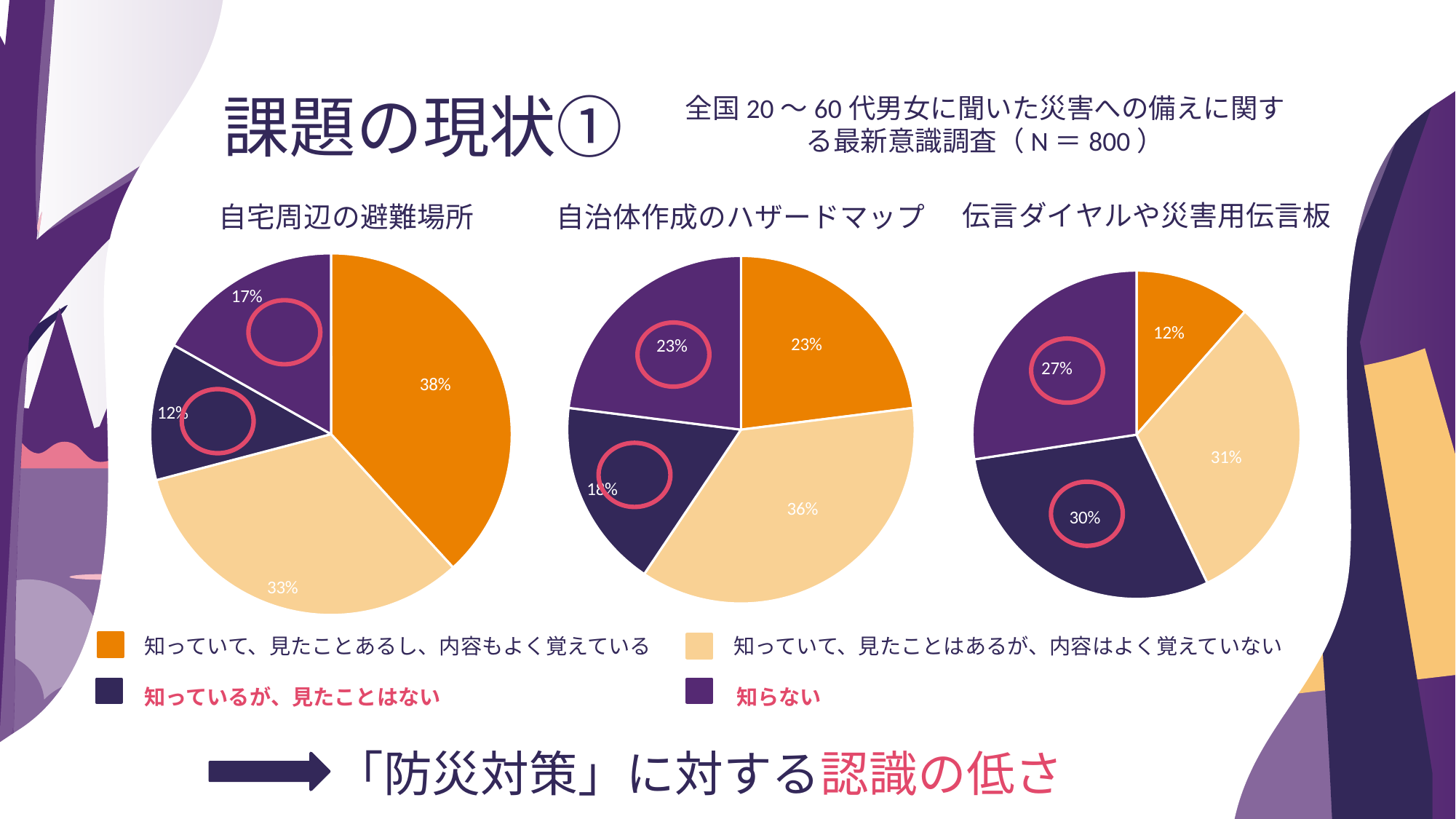
In the 自治体作成のハザードマップ pie chart, what share is labelled for 知っていて、見たことはあるが、内容はよく覚えていない? 36% In the 自宅周辺の避難場所 pie chart, which category has the largest share? 知っていて、見たことあるし、内容もよく覚えている In the 伝言ダイヤルや災害用伝言板 pie chart, what share is labelled for 知らない? 27% In the 自宅周辺の避難場所 pie chart, what is the difference in percentage points between the 38% slice and the 33% slice? 5 In the 自宅周辺の避難場所 pie chart, what share is labelled for the 知らない slice? 17% In the 伝言ダイヤルや災害用伝言板 pie chart, which category has the smallest share? 知っていて、見たことあるし、内容もよく覚えている In the 伝言ダイヤルや災害用伝言板 pie chart, what share is labelled for 知っていて、見たことあるし、内容もよく覚えている? 12% How many pie charts are shown on the slide? 3 In the 自宅周辺の避難場所 pie chart, which category has the smallest share? 知っているが、見たことはない Which is larger in the 自治体作成のハザードマップ pie chart: the share for 知っていて、見たことはあるが、内容はよく覚えていない or the share for 知らない? 知っていて、見たことはあるが、内容はよく覚えていない How many categories does the legend list for the pie charts? 4 In the 自治体作成のハザードマップ pie chart, what share is labelled for 知っているが、見たことはない? 18%